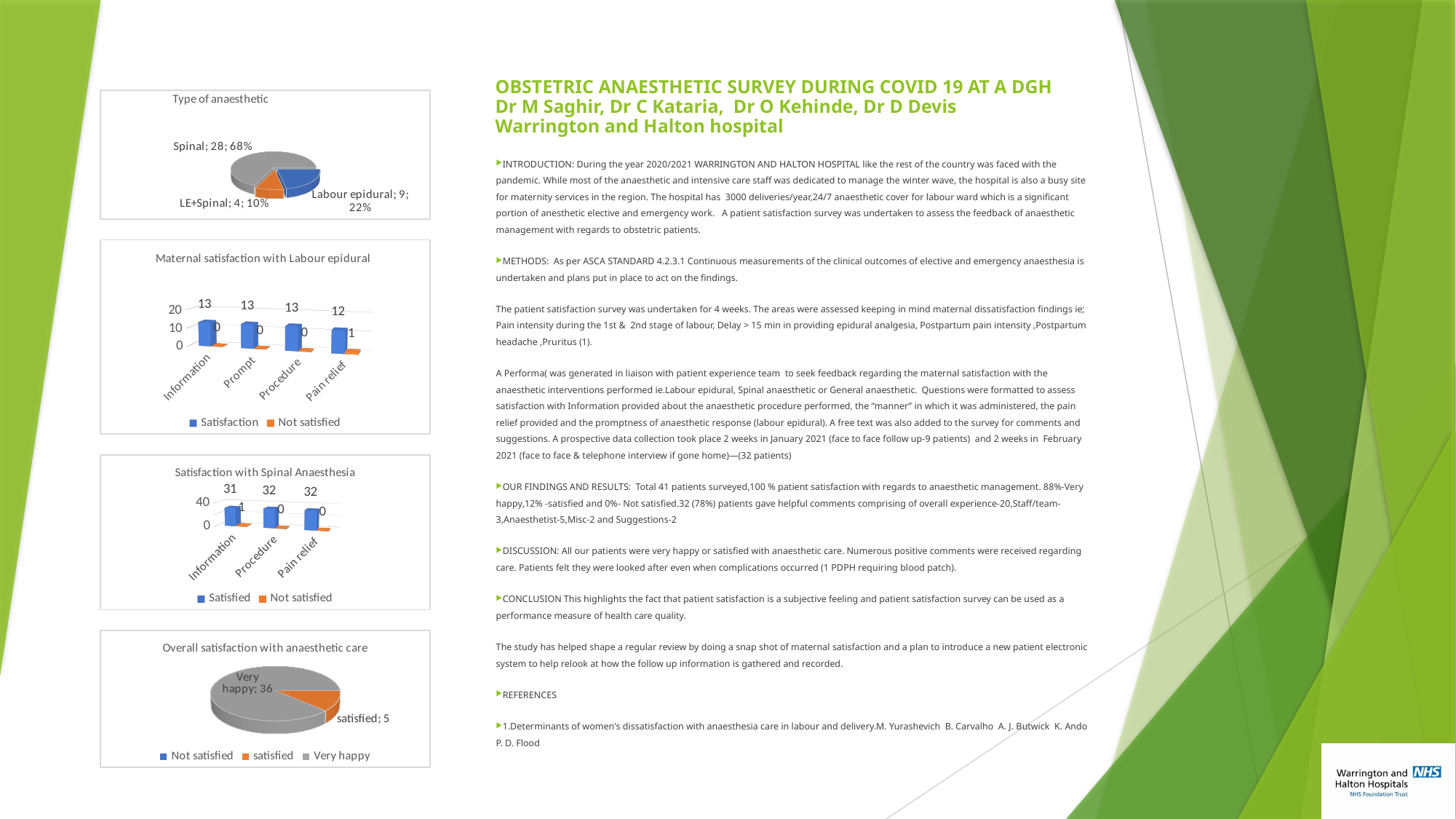
In the 'Type of anaesthetic' chart, how many patients had a labour epidural? 9 How many series does the legend of the 'Satisfaction with Spinal Anaesthesia' chart list? 2 What kind of chart is 'Type of anaesthetic'? Pie chart In the 'Maternal satisfaction with Labour epidural' chart, what is the Not satisfied value for Pain relief? 1 In the 'Type of anaesthetic' chart, which type of anaesthetic has the smallest slice? LE+Spinal In the 'Overall satisfaction with anaesthetic care' chart, how many patients were Very happy? 36 In the 'Satisfaction with Spinal Anaesthesia' chart, what is the difference between the Satisfied values for Procedure and Information? 1 In the 'Type of anaesthetic' chart, what percentage of patients had a spinal anaesthetic? 68% In the 'Satisfaction with Spinal Anaesthesia' chart, what is the Satisfied value for Information? 31 In the 'Maternal satisfaction with Labour epidural' chart, what is the Satisfaction value for Pain relief? 12 In the 'Overall satisfaction with anaesthetic care' chart, which is larger: Very happy or satisfied? Very happy How many categories are shown on the x axis of the 'Maternal satisfaction with Labour epidural' chart? 4